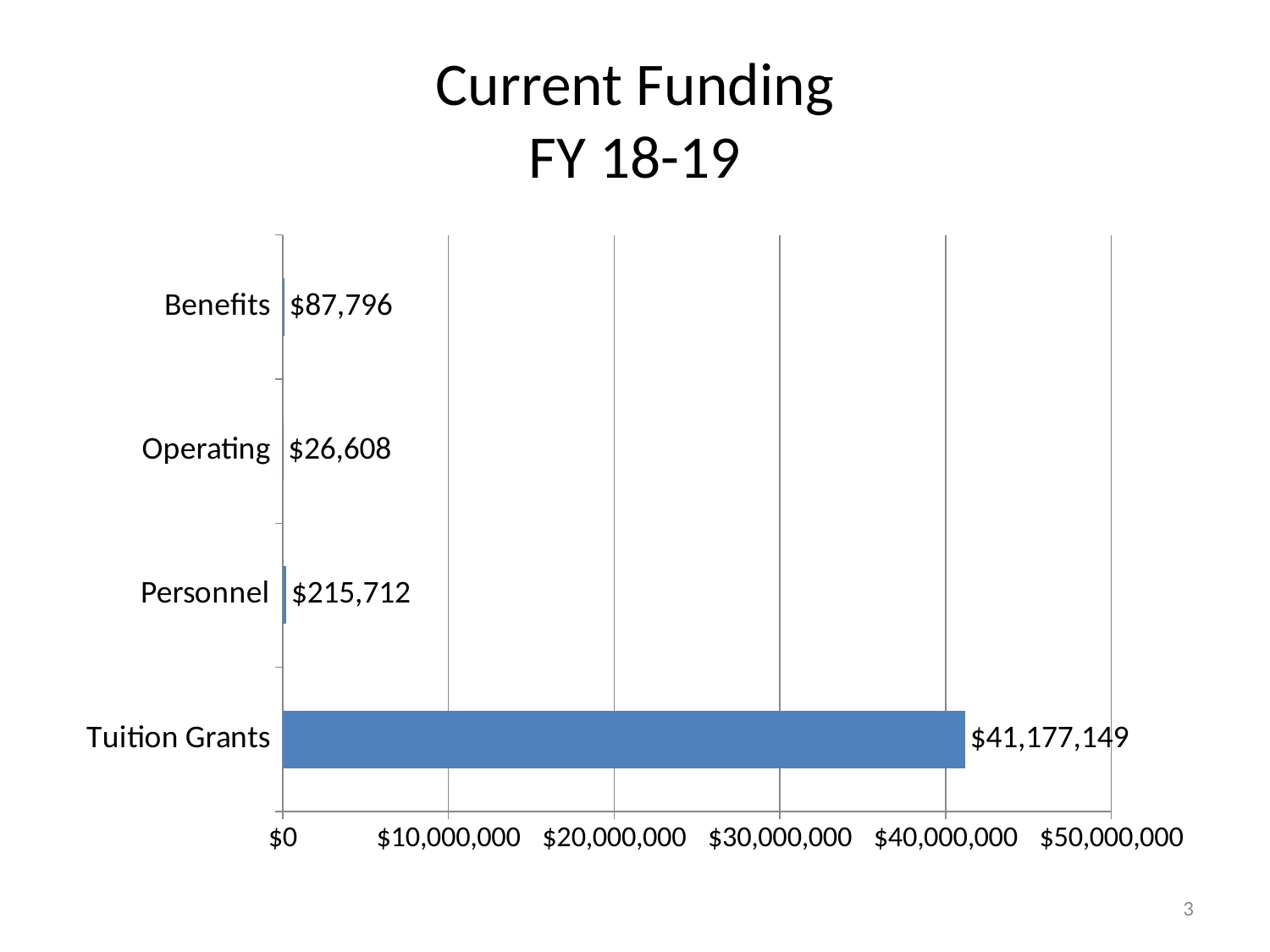
Which is larger, the value for Benefits or the value for Operating? Benefits What is the value for Tuition Grants? $41,177,149 What kind of chart is shown on the slide? bar chart Which category has the highest value? Tuition Grants What is the difference between the values for Personnel and Benefits? $127,916 Which category has the lowest value? Operating What is the value for Benefits? $87,796 Is the value for Tuition Grants greater or less than $40,000,000? greater How many categories are shown in the chart? 4 What is the value for Operating? $26,608 What is the value for Personnel? $215,712 What is the difference between the values for Benefits and Operating? $61,188